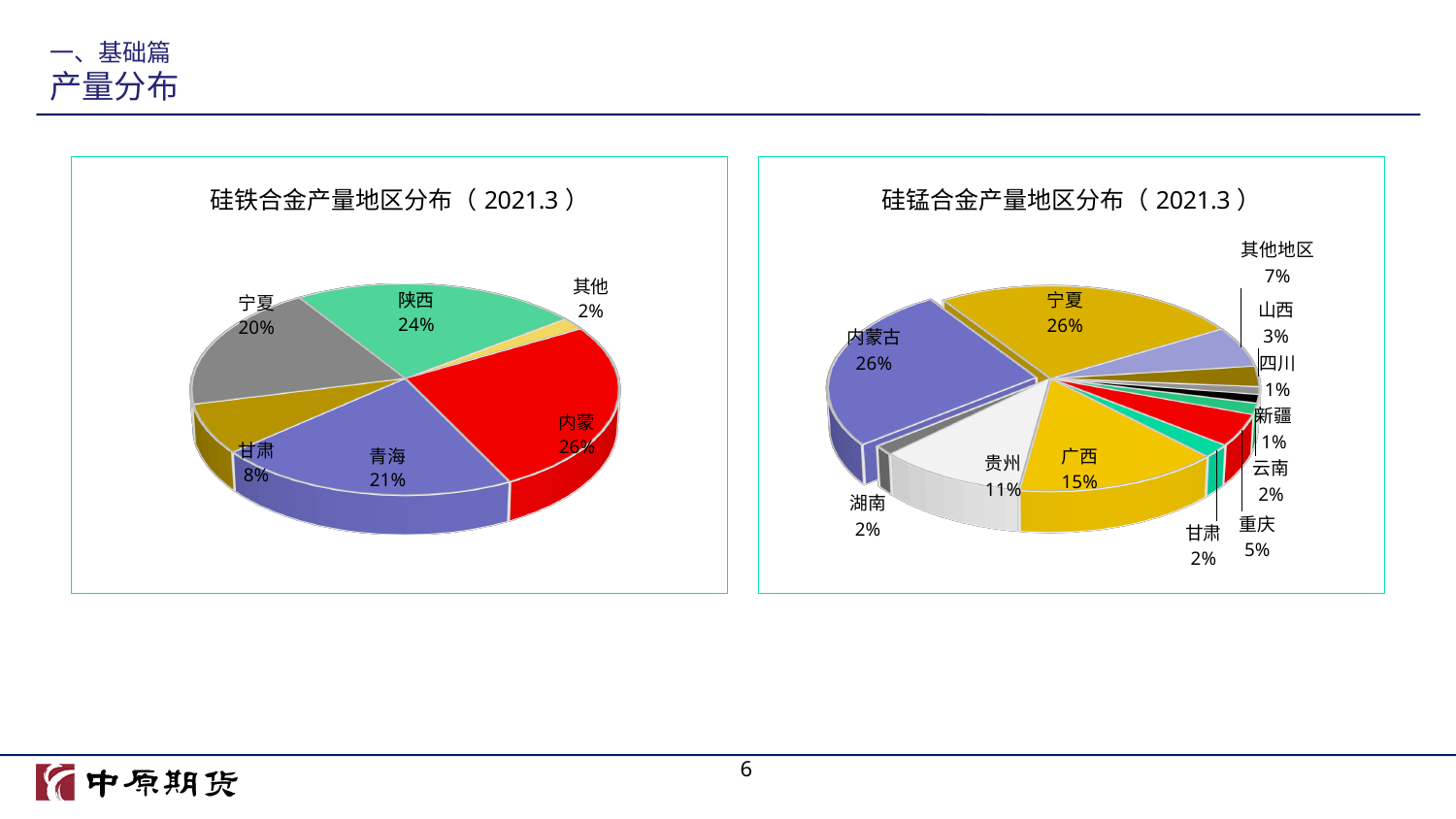
In the left chart, 硅铁合金产量地区分布（2021.3）, which is larger, the share of 宁夏 or the share of 青海? 青海 In the right chart, 硅锰合金产量地区分布（2021.3）, what is the difference between the shares of 内蒙古 and 广西? 11% In the right chart, 硅锰合金产量地区分布（2021.3）, what share does 贵州 have? 11% In the left chart, 硅铁合金产量地区分布（2021.3）, which region has the largest share? 内蒙 In the left chart, 硅铁合金产量地区分布（2021.3）, which slice has the smallest share? 其他 In the left chart, 硅铁合金产量地区分布（2021.3）, how many slices does the pie have? 6 In the left chart, 硅铁合金产量地区分布（2021.3）, what share does 青海 have? 21% In the right chart, 硅锰合金产量地区分布（2021.3）, what share does 广西 have? 15% In the right chart, 硅锰合金产量地区分布（2021.3）, how many slices does the pie have? 12 What kind of chart is the left chart, 硅铁合金产量地区分布（2021.3）? pie chart In the right chart, 硅锰合金产量地区分布（2021.3）, which is larger, the share of 重庆 or the share of 山西? 重庆 In the left chart, 硅铁合金产量地区分布（2021.3）, what is the difference between the shares of 陕西 and 甘肃? 16%